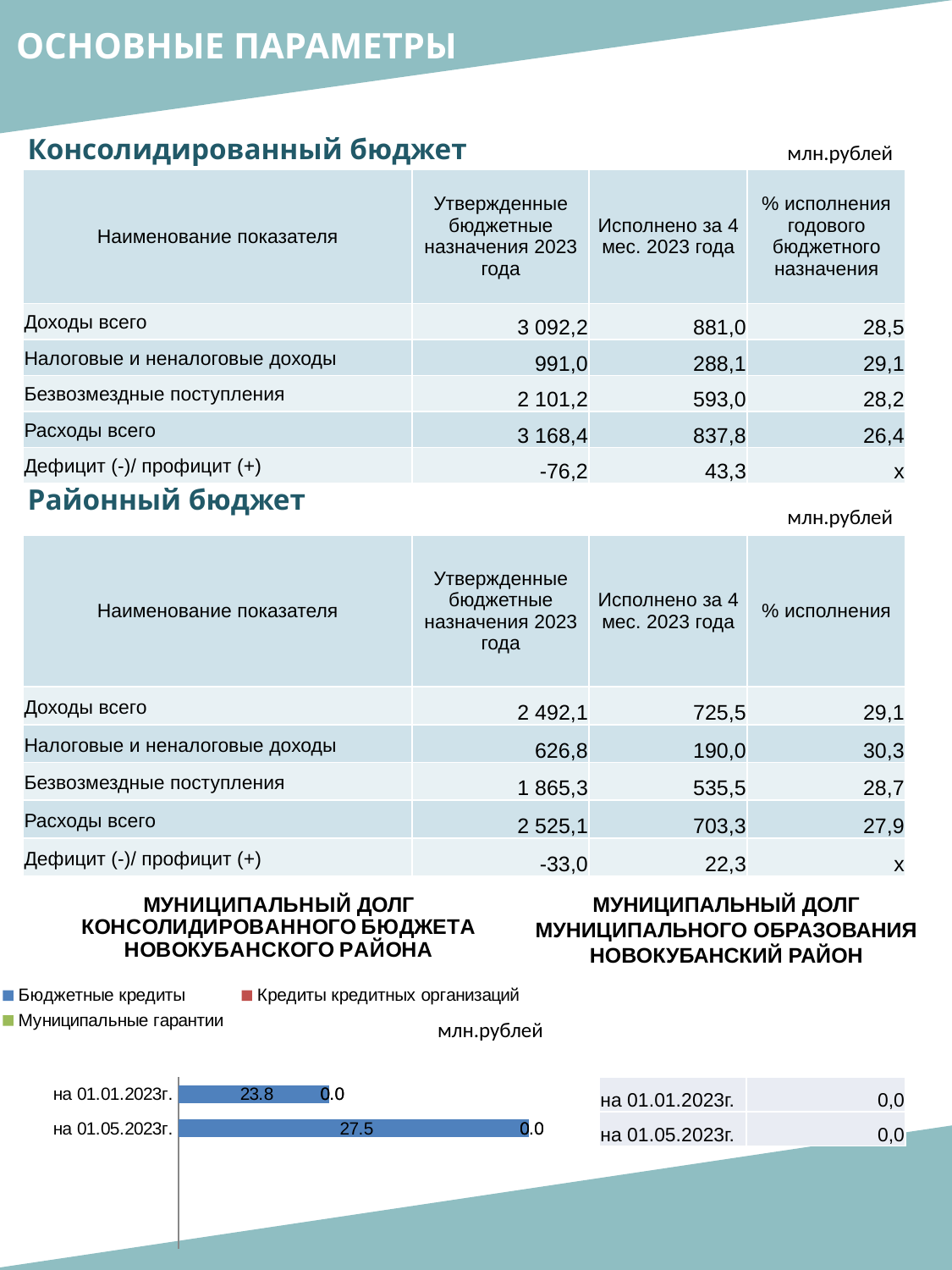
In the bar chart, which date has the higher value for 'Бюджетные кредиты'? на 01.05.2023г. How many date categories are shown in the bar chart? 2 What unit is indicated for the values in the bar chart? млн.рублей In the bar chart, what is the value labelled next to the 'Бюджетные кредиты' bar for 'на 01.01.2023г.' for the other series? 0.0 What type of chart is shown under the title 'МУНИЦИПАЛЬНЫЙ ДОЛГ КОНСОЛИДИРОВАННОГО БЮДЖЕТА НОВОКУБАНСКОГО РАЙОНА'? bar chart Which legend entry in the bar chart is shown in blue? Бюджетные кредиты In the bar chart, is the 'Бюджетные кредиты' value for 'на 01.05.2023г.' larger or smaller than for 'на 01.01.2023г.'? larger In the bar chart, by how much did 'Бюджетные кредиты' change from 'на 01.01.2023г.' to 'на 01.05.2023г.'? 3.7 How many series does the legend of the bar chart list? 3 In the bar chart, what is the value of 'Бюджетные кредиты' for 'на 01.05.2023г.'? 27.5 In the bar chart, what is the value of 'Бюджетные кредиты' for 'на 01.01.2023г.'? 23.8 In the bar chart, which date has the lower value for 'Бюджетные кредиты'? на 01.01.2023г.